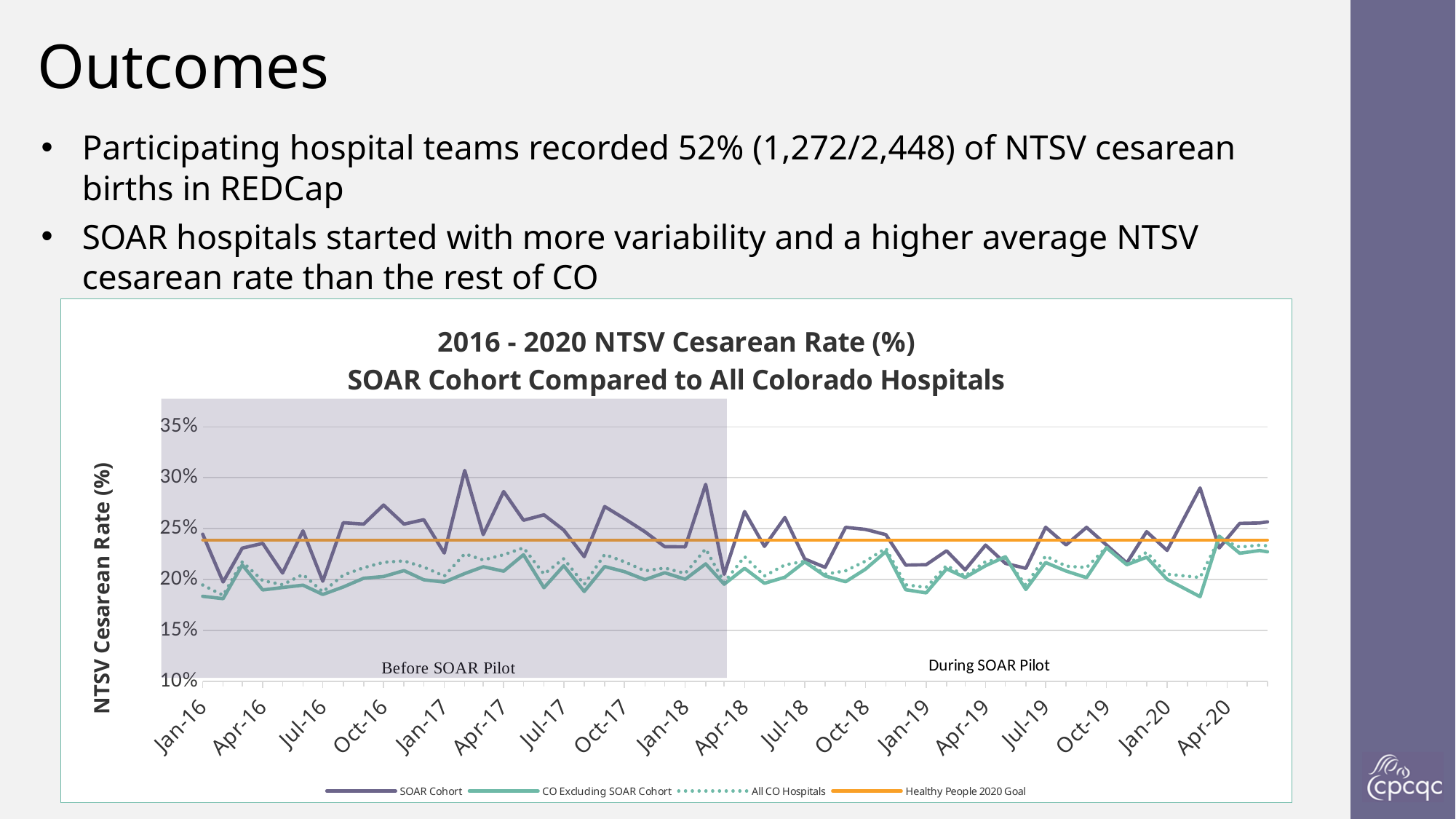
What kind of chart is shown on the slide? Line chart What is the highest value shown on the y axis? 35% At Jan-16, which series has the higher value: SOAR Cohort or CO Excluding SOAR Cohort? SOAR Cohort Is the CO Excluding SOAR Cohort series ever above 25% on the chart? No Is the SOAR Cohort value at Jan-16 greater or less than 20%? greater What is the title of the chart? 2016 - 2020 NTSV Cesarean Rate (%) SOAR Cohort Compared to All Colorado Hospitals Is the highest SOAR Cohort value on the chart greater or less than 30%? greater What label is shown in the shaded region on the left side of the chart? Before SOAR Pilot How many series does the chart's legend list? 4